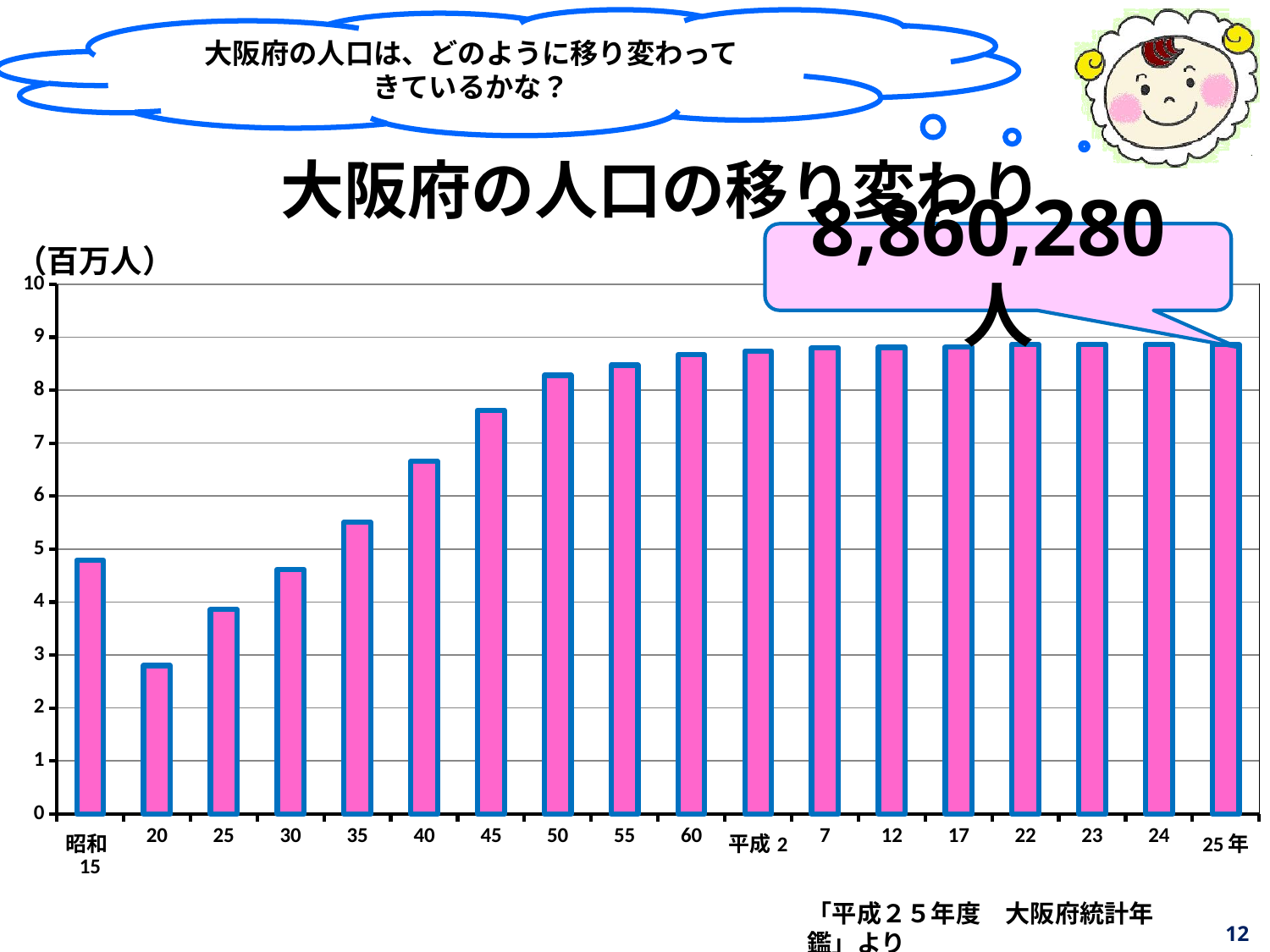
Is the value for 昭和15 greater or less than 4? greater What unit is shown for the vertical axis of the chart? 百万人 Is the value for 昭和35 greater or less than 6? less Is the value for 昭和40 greater or less than 6? greater What kind of chart is shown on the slide? bar chart From 昭和20 onward, do the population values generally rise or fall along the x axis? rise What is the title of the chart? 大阪府の人口の移り変わり Which year has the lowest population bar in the chart? 昭和20 Which is larger, the value for 昭和25 or the value for 昭和30? 昭和30 How many bars (years) are plotted in the chart? 18 What population value does the callout give for 平成25年? 8,860,280人